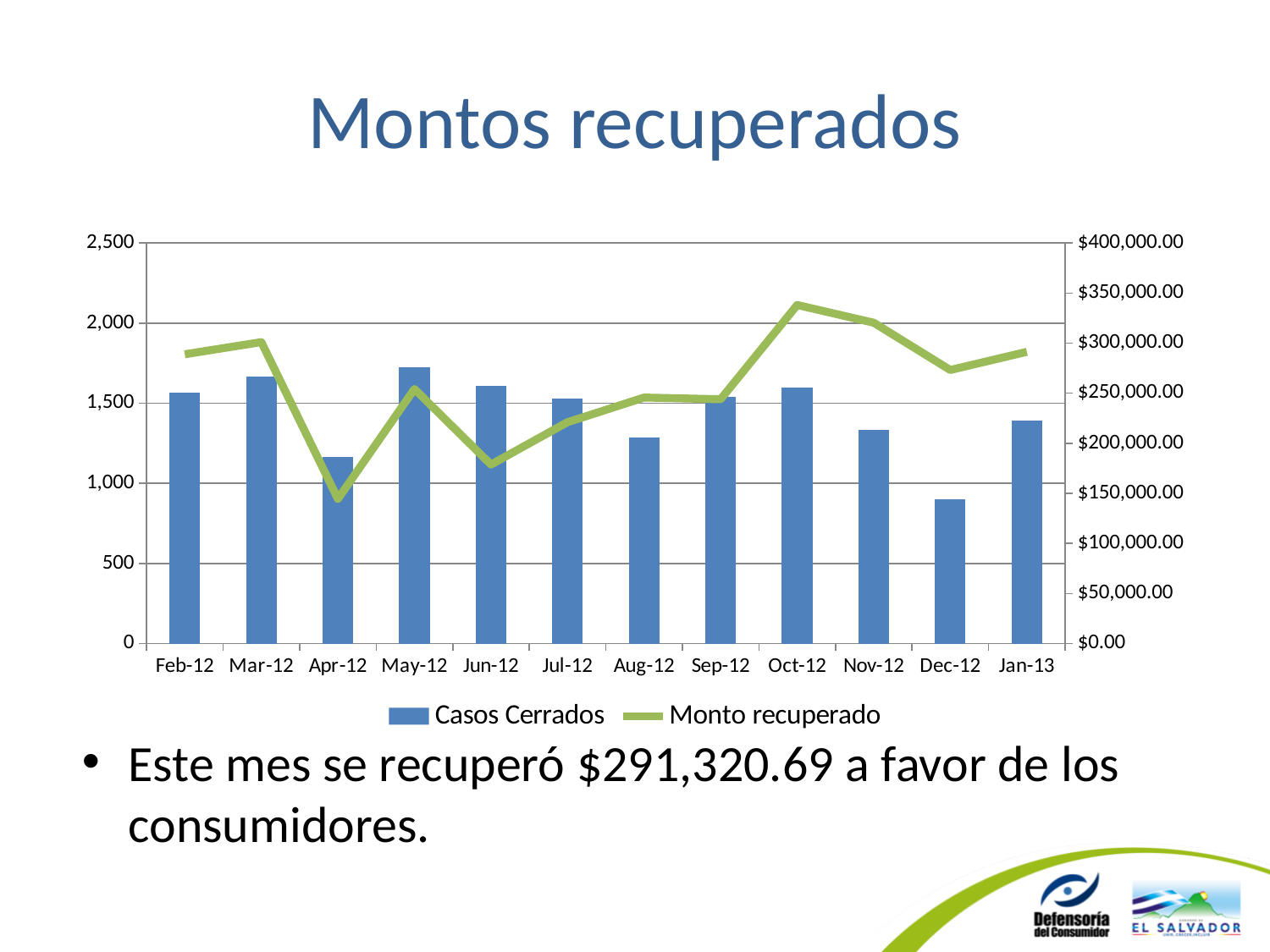
What type of chart is shown on the slide? A combination bar and line chart What are the two series named in the chart legend? Casos Cerrados and Monto recuperado Which month has the lowest number of Casos Cerrados? Dec-12 Is the number of Casos Cerrados for Dec-12 greater or less than 1,000? less Which month has the lowest Monto recuperado? Apr-12 How many series does the chart legend list? 2 Which month has more Casos Cerrados, Mar-12 or Apr-12? Mar-12 Which month has the highest Monto recuperado? Oct-12 Is the Monto recuperado for Oct-12 greater or less than $300,000.00? greater How many months are shown on the x axis of the chart? 12 Does the Monto recuperado rise or fall from Oct-12 to Dec-12? fall Which month has the highest number of Casos Cerrados? May-12